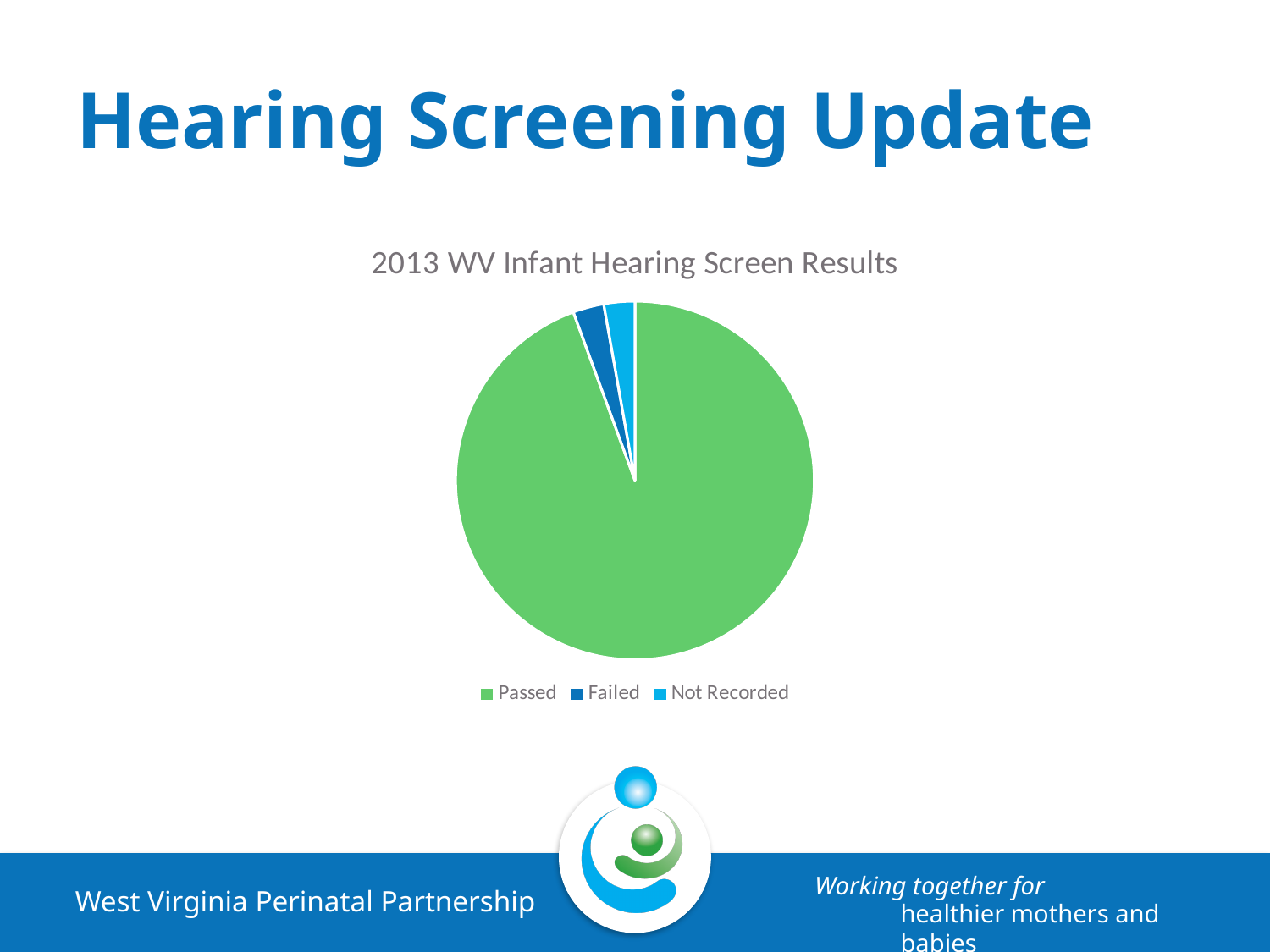
What kind of chart is shown on the slide? pie chart What is the title of the chart? 2013 WV Infant Hearing Screen Results Which is larger, the Passed slice or the Failed slice? Passed What colour is the Passed slice in the pie chart? green How many entries does the chart legend list? 3 Which is larger, the Passed slice or the Not Recorded slice? Passed Which categories are listed in the legend of the pie chart? Passed, Failed, Not Recorded How many categories does the pie chart show? 3 Which category has the largest slice of the pie? Passed